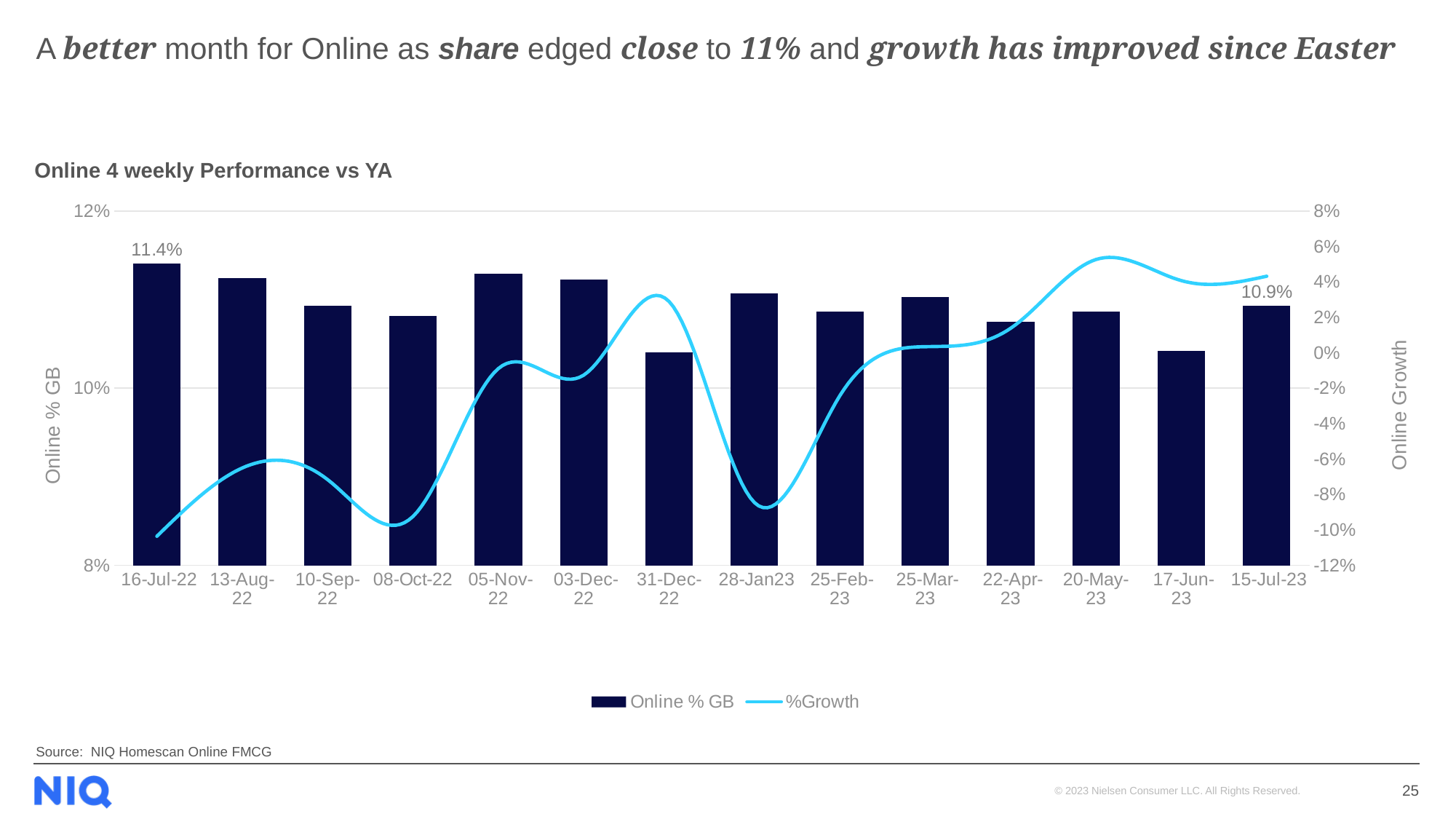
What is the difference between the Online % GB values for 16-Jul-22 and 15-Jul-23? 0.5 percentage points What kind of chart is this? Combination bar and line chart Is the Online % GB value for 31-Dec-22 greater or less than 10%? greater Which period has the highest Online % GB bar? 16-Jul-22 Is the %Growth value for 16-Jul-22 greater or less than -8%? less Which has the larger Online % GB bar, 05-Nov-22 or 08-Oct-22? 05-Nov-22 Which period has the lowest Online % GB bar? 31-Dec-22 Does the %Growth line rise or fall from 28-Jan23 to 20-May-23? rise What is the Online % GB value for 15-Jul-23? 10.9% How many periods are shown on the x axis? 14 How many series does the legend list? 2 What is the Online % GB value for 16-Jul-22? 11.4%